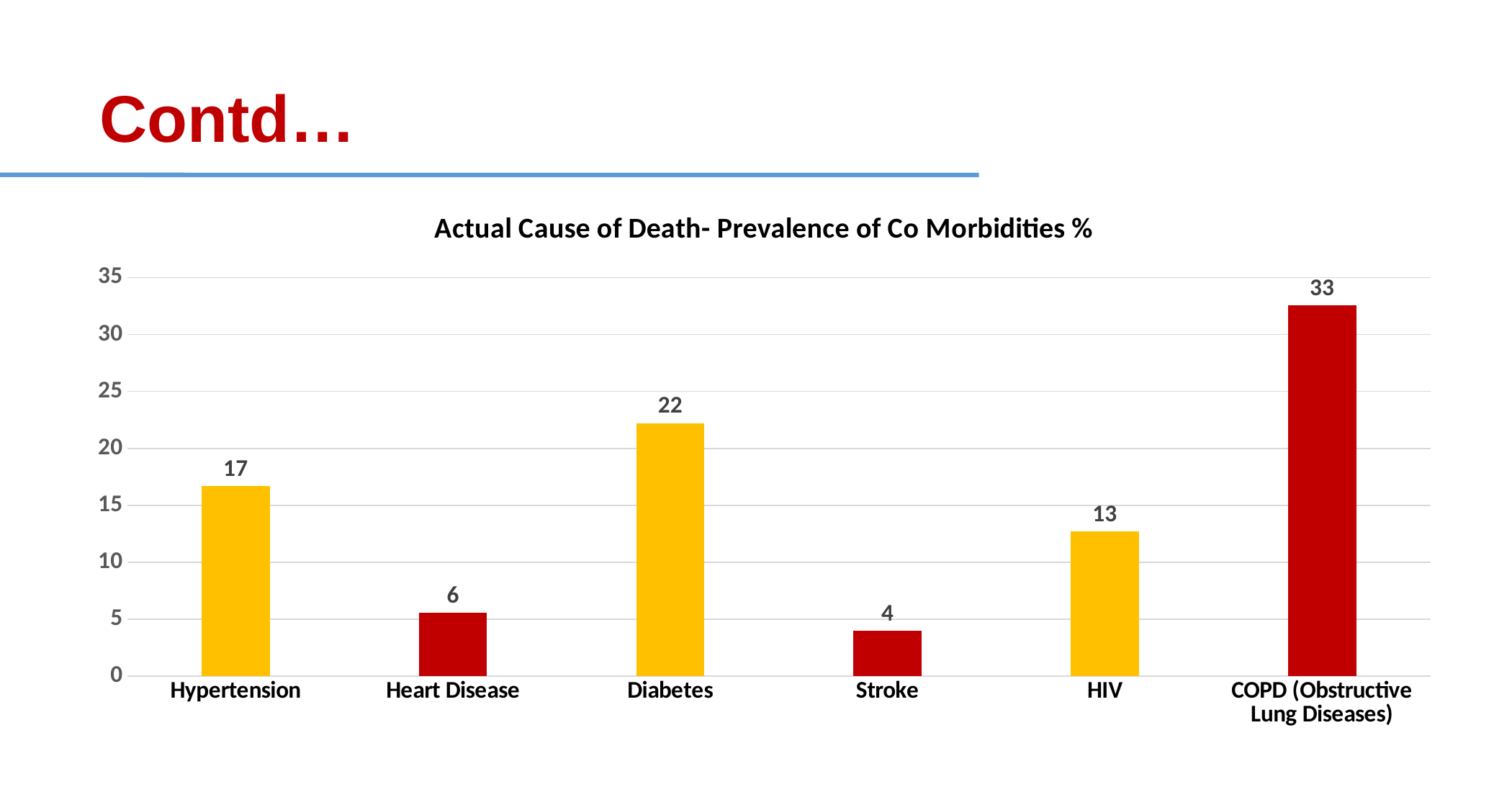
What colour is the bar for Diabetes? yellow What is the value for Stroke? 4 What kind of chart is shown on the slide? bar chart Which category has the highest value? COPD (Obstructive Lung Diseases) How many categories are shown on the x axis? 6 Which is larger, the value for Hypertension or the value for HIV? Hypertension Which category has the lowest value? Stroke What is the value for Hypertension? 17 Is the value for Heart Disease greater or less than 10? less What is the value for COPD (Obstructive Lung Diseases)? 33 What is the title of the chart? Actual Cause of Death- Prevalence of Co Morbidities % What is the difference between the values for Diabetes and HIV? 9